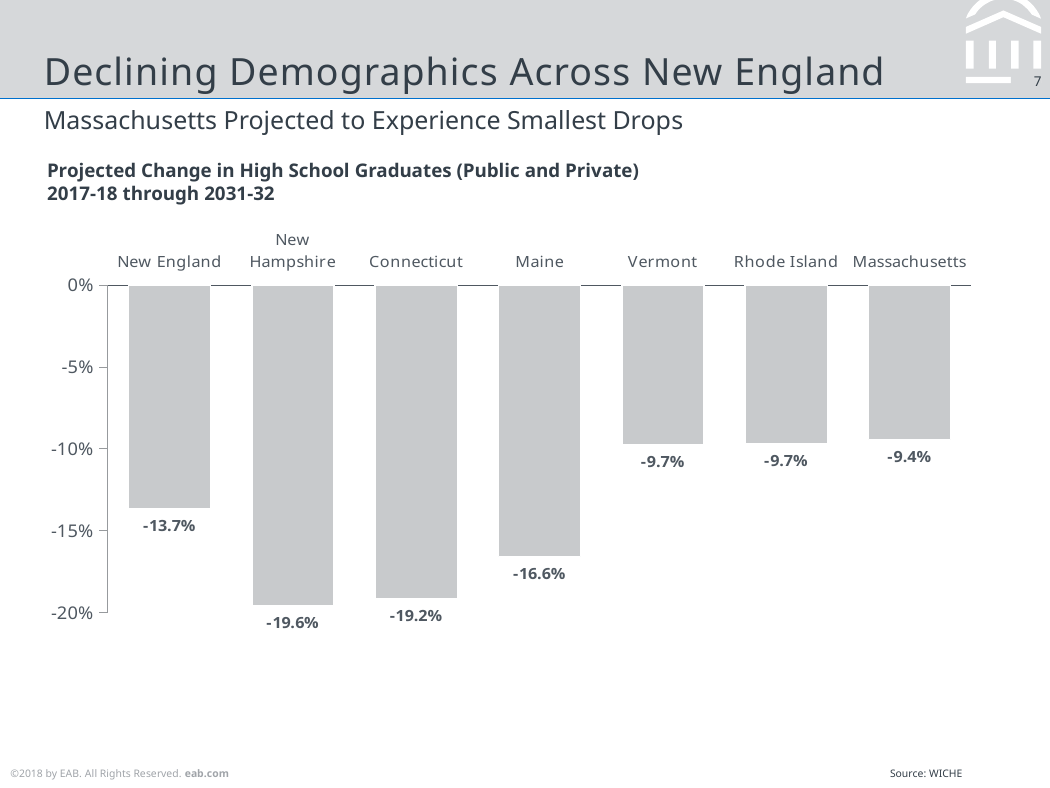
Is the value for Maine greater or less than -15%? less What is the difference in percentage points between the values for Maine and New England? 2.9 percentage points Which has a larger projected decline, Maine or New England? Maine How many categories are shown in the chart? 7 What is the projected change in high school graduates for Connecticut? -19.2% What is the projected change in high school graduates for Maine? -16.6% What is the projected change in high school graduates for New England? -13.7% What is the difference in percentage points between the values for New Hampshire and Connecticut? 0.4 percentage points What kind of chart is shown on the slide? Bar chart What is the source cited for the chart data? WICHE Which category shows the smallest projected decline (the highest value)? Massachusetts Which category shows the largest projected decline (the lowest value)? New Hampshire